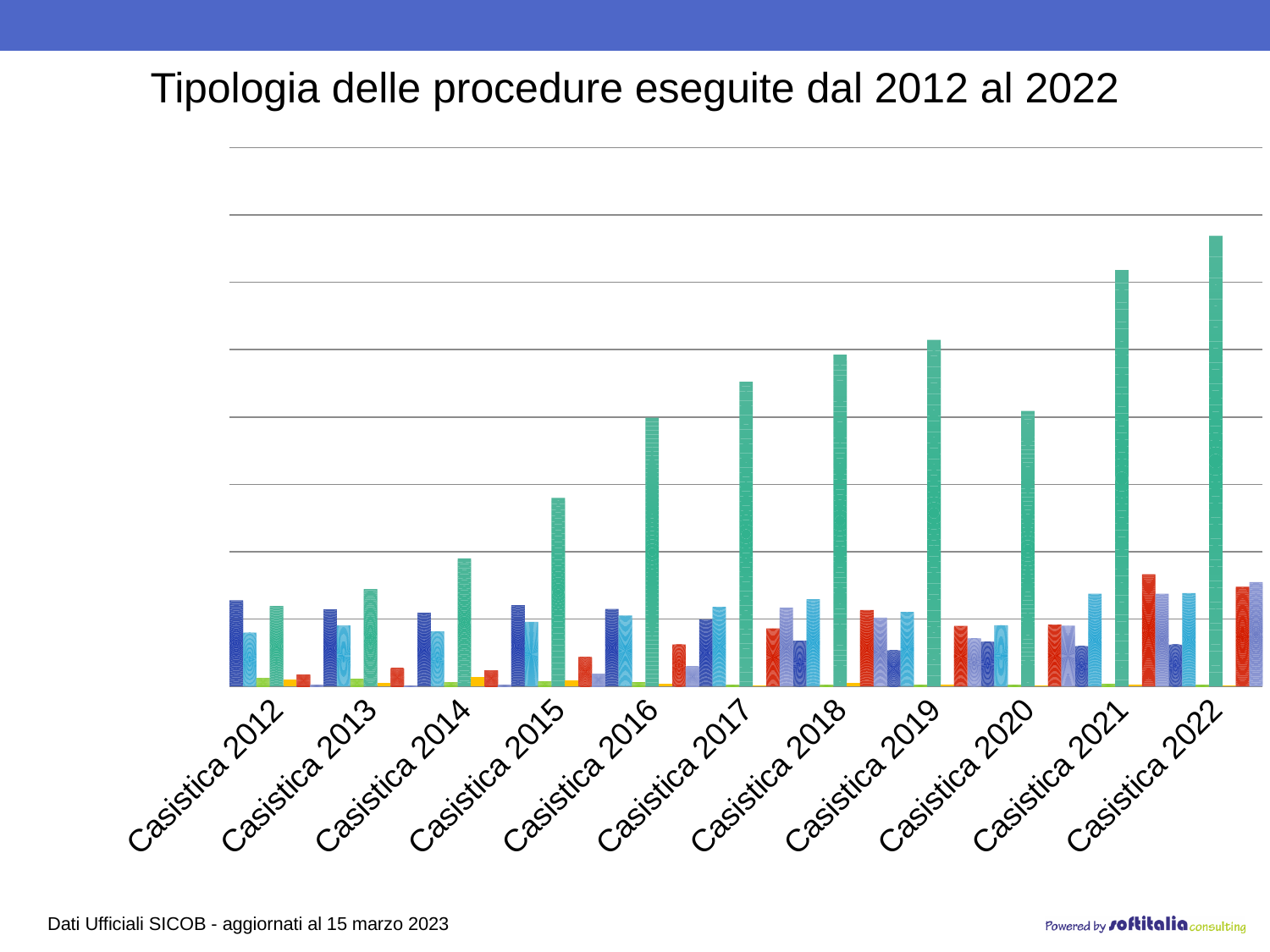
What is the title of the chart? Tipologia delle procedure eseguite dal 2012 al 2022 Which category has the shortest green bar? Casistica 2012 What kind of chart is shown on the slide? bar chart Is the tallest (green) bar for Casistica 2022 taller or shorter than the tallest bar for Casistica 2021? taller Is the green bar for Casistica 2016 taller or shorter than the green bar for Casistica 2015? taller Overall, do the tallest (green) bars rise or fall from Casistica 2012 to Casistica 2022? rise Which category contains the tallest bar in the chart? Casistica 2022 What is the first category label on the x axis? Casistica 2012 Is the tallest (green) bar for Casistica 2020 taller or shorter than the tallest bar for Casistica 2019? shorter How many categories are shown along the x axis of the chart? 11